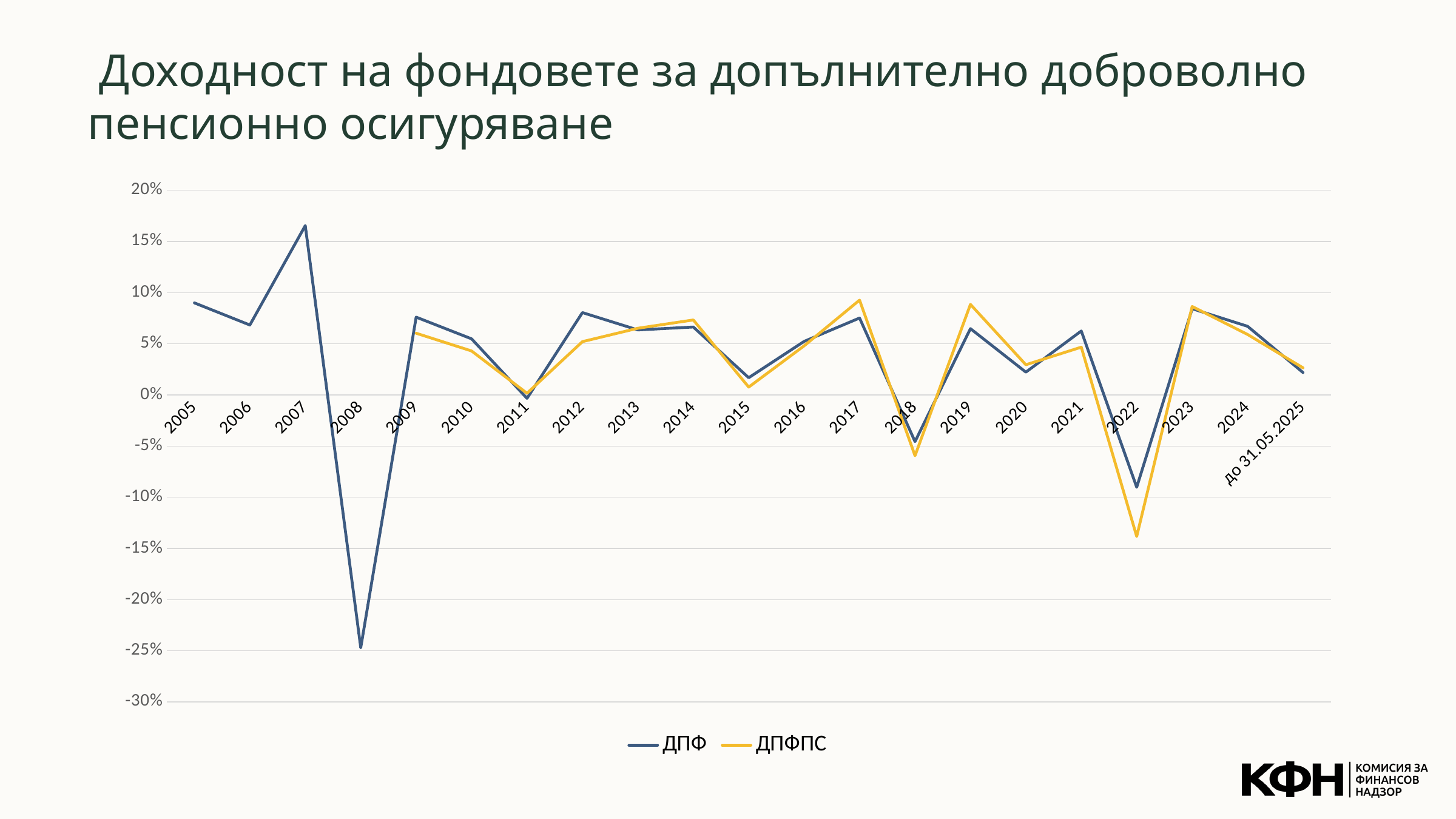
Is the value for ДПФ in 2008 greater or less than -20%? less What kind of chart is shown on the slide? line chart How many series does the legend list? 2 Does the ДПФ series rise or fall from 2023 to до 31.05.2025? fall In which year does the ДПФ series reach its highest value? 2007 In which year does the ДПФ series reach its lowest value? 2008 How many points are there along the x axis? 21 Which series has the larger value in 2022, ДПФ or ДПФПС? ДПФ Is the value for ДПФПС in 2022 greater or less than -10%? less In which year does the ДПФПС series reach its lowest value? 2022 Is the value for ДПФ in 2007 greater or less than 15%? greater Which series has the larger value in 2019, ДПФ or ДПФПС? ДПФПС